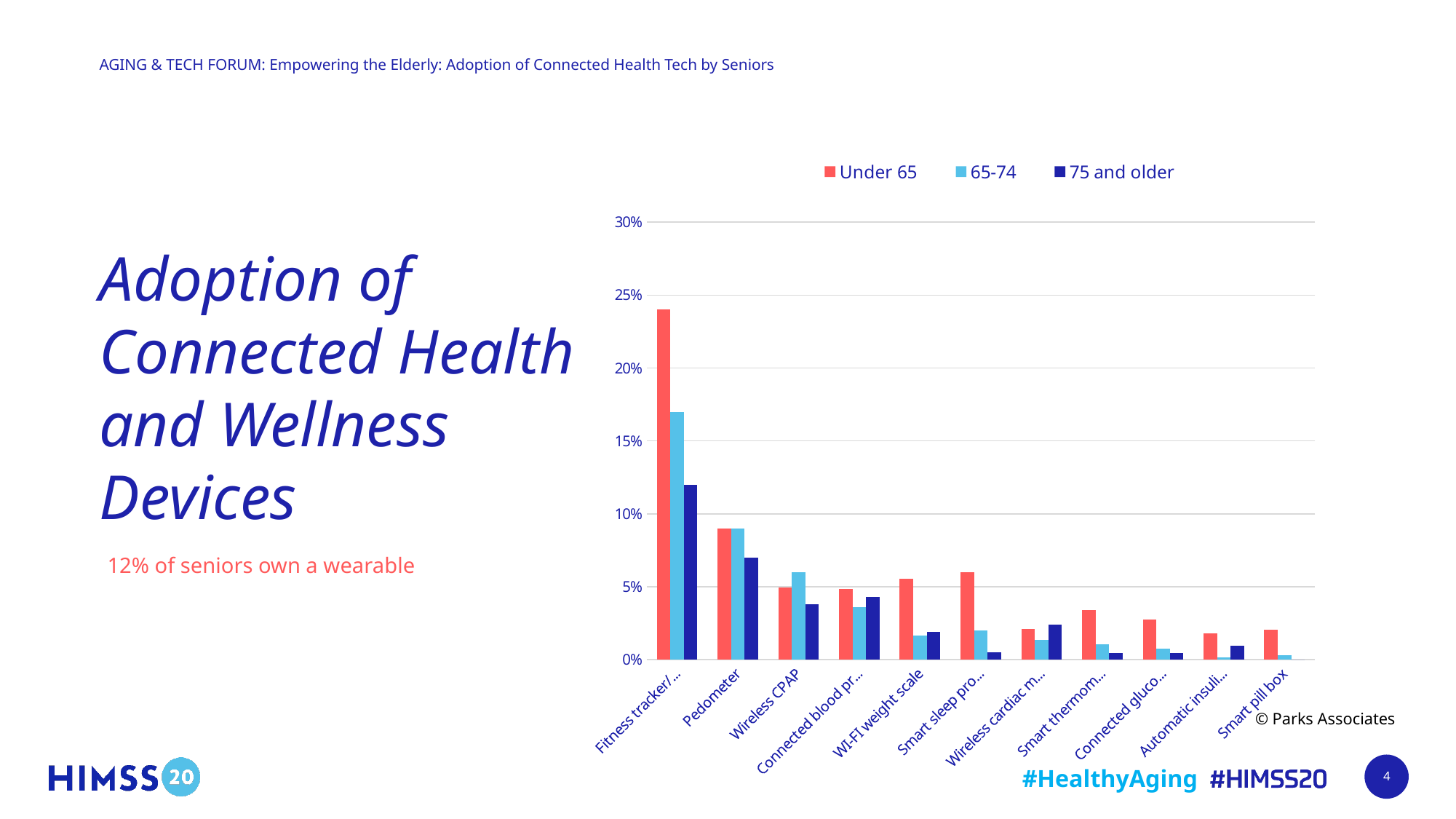
For Fitness tracker, which is larger: the Under 65 value or the 75 and older value? Under 65 Do the Under 65 values generally rise or fall moving from left to right across the categories? fall Is the 75 and older value for Fitness tracker greater or less than 10%? greater Which device category has the highest value for the Under 65 series? Fitness tracker Is the 65-74 value for Fitness tracker greater or less than 15%? greater How many device categories are shown on the x axis? 11 What kind of chart is shown on the slide? bar chart Is the Under 65 value for Pedometer greater or less than 10%? less For Wireless CPAP, which is larger: the 65-74 value or the 75 and older value? 65-74 Which colour represents the 75 and older series in the legend? dark blue How many series does the legend list? 3